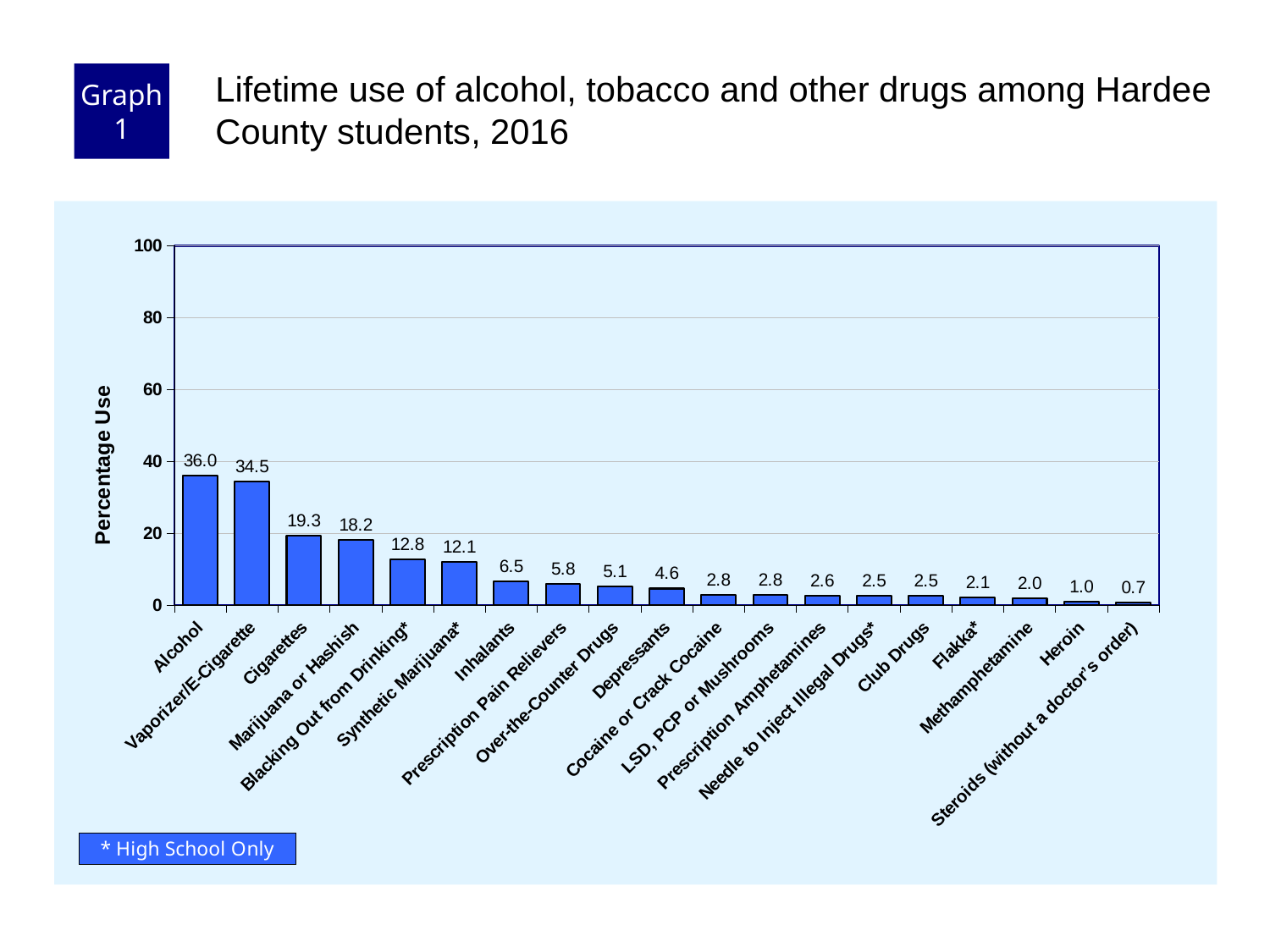
What is the label of the y axis? Percentage Use What is the percentage use for Synthetic Marijuana*? 12.1 How many categories are shown on the x axis? 19 Do the values rise or fall moving left to right along the x axis? Fall What kind of chart is shown on the slide? Bar chart What is the difference in percentage use between Cigarettes and Marijuana or Hashish? 1.1 Which category has the highest percentage use? Alcohol Which category has the lowest percentage use? Steroids (without a doctor's order) Which has a higher percentage use, Inhalants or Prescription Pain Relievers? Inhalants What is the percentage use for Alcohol? 36.0 What is the percentage use for Vaporizer/E-Cigarette? 34.5 What is the percentage use for Heroin? 1.0